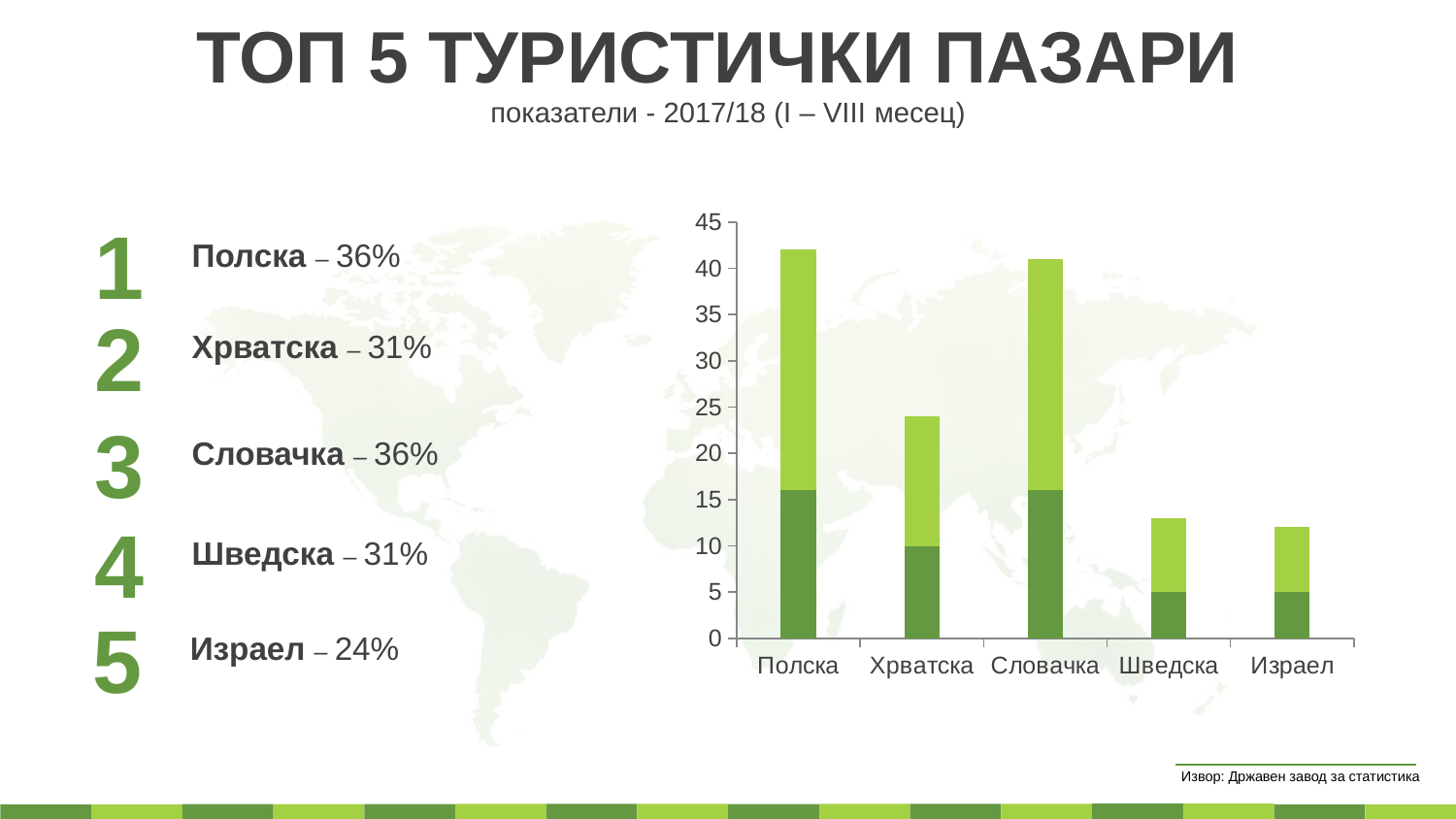
Is the total value of the bar for Шведска greater or less than 20? less Is the total value of the bar for Полска greater or less than 35? greater Which bar is taller in the chart, Полска or Хрватска? Полска What is the highest value shown on the y axis of the chart? 45 How many countries are shown on the x axis of the chart? 5 Is the total value of the bar for Израел greater or less than 20? less Which bar is taller in the chart, Хрватска or Шведска? Хрватска Which bar is taller in the chart, Словачка or Израел? Словачка What kind of chart is shown on the slide? bar chart Which country is listed first on the x axis of the chart? Полска